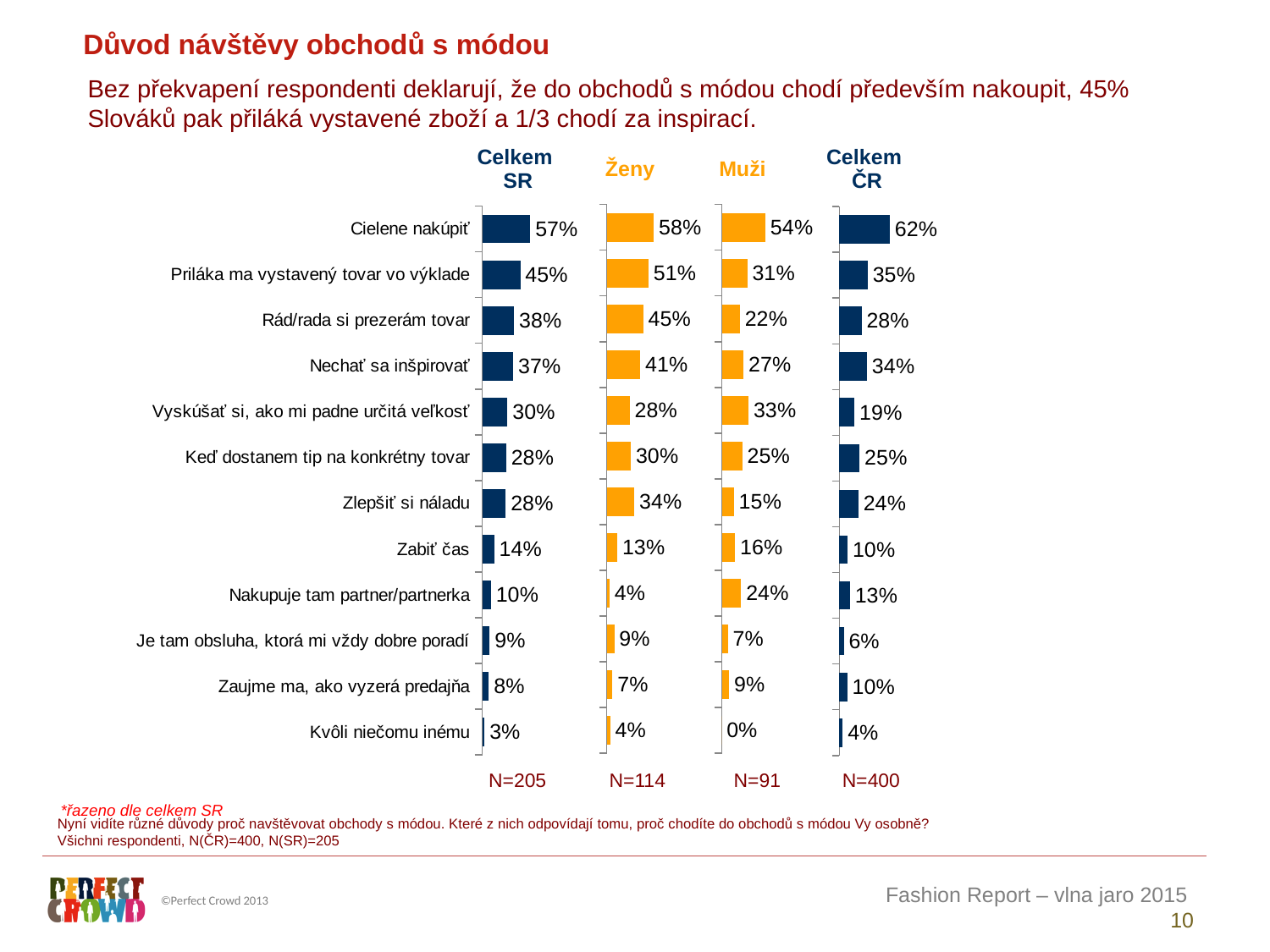
What kind of chart is the Celkem SR chart? Bar chart In the Muži chart, what is the value for "Nakupuje tam partner/partnerka"? 24% In the Celkem ČR chart, which category has the highest value? Cielene nakúpiť In the Ženy chart, what is the value for "Priláka ma vystavený tovar vo výklade"? 51% In the Muži chart, which category has the lowest value? Kvôli niečomu inému How many categories are shown in the Celkem SR chart? 12 In the Ženy chart, what is the difference between "Cielene nakúpiť" and "Priláka ma vystavený tovar vo výklade"? 7 percentage points Which is larger: the value for "Zlepšiť si náladu" in the Ženy chart or in the Muži chart? Ženy What colour are the bars in the Ženy and Muži charts? Orange What is the sample size (N) shown under the Muži chart? N=91 In the Celkem SR chart, what is the value for "Cielene nakúpiť"? 57% In the Celkem ČR chart, what is the value for "Nechať sa inšpirovať"? 34%